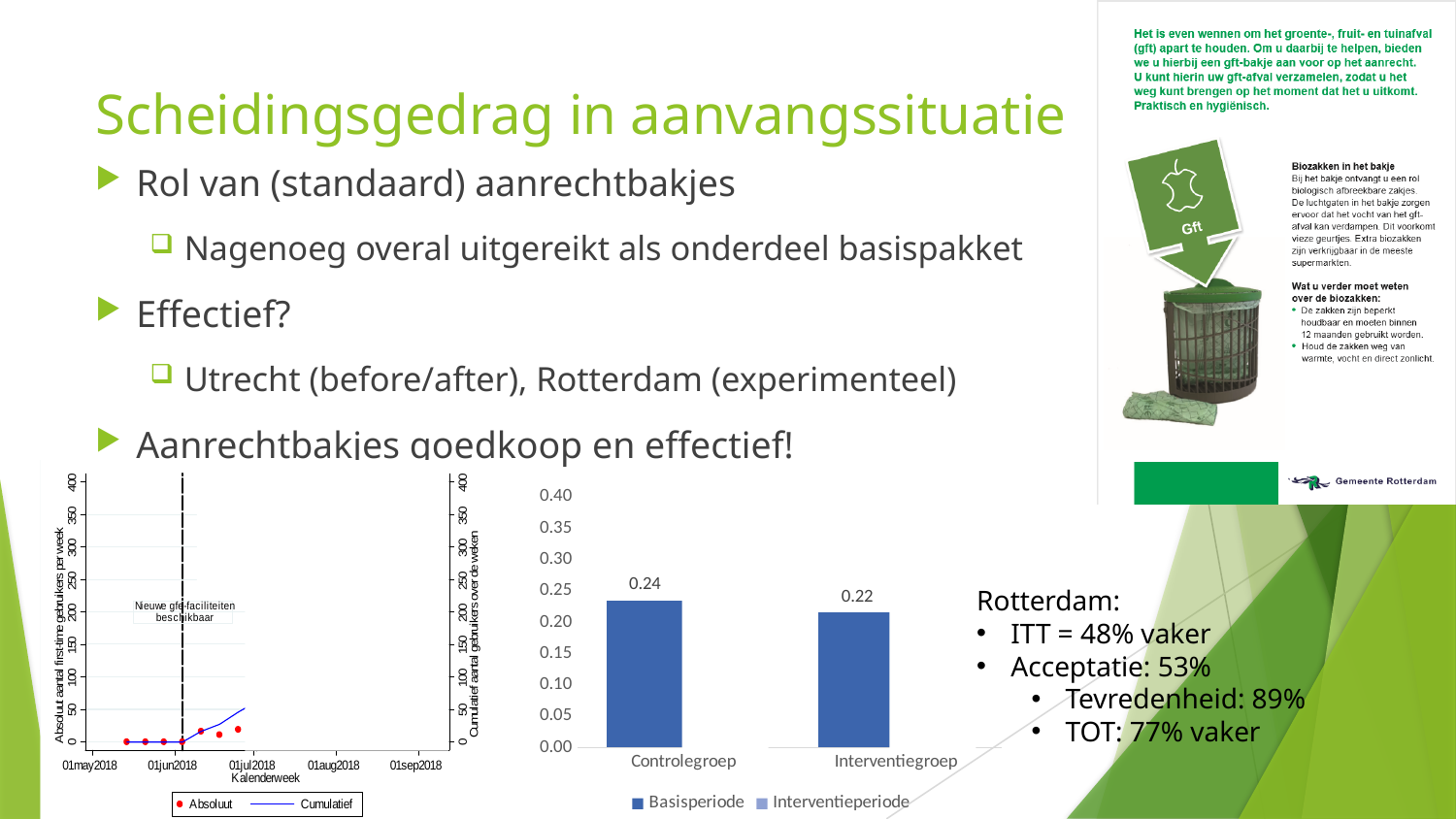
In the bar chart in the middle of the slide, what is the difference between the Controlegroep and Interventiegroep values? 0.02 How many categories are shown on the x axis of the bar chart in the middle of the slide? 2 In the bar chart in the middle of the slide, what is the value for Interventiegroep? 0.22 What kind of chart is the chart in the middle of the slide? bar chart In the bar chart in the middle of the slide, is the value for Controlegroep greater or less than 0.20? greater In the bar chart in the middle of the slide, which group has the lower value? Interventiegroep What is the x-axis label of the chart at the bottom left of the slide? Kalenderweek How many series does the legend of the bar chart in the middle of the slide list? 2 In the chart at the bottom left of the slide, how many series does the legend list? 2 In the bar chart in the middle of the slide, which group has the higher value? Controlegroep In the chart at the bottom left of the slide, does the Cumulatief line rise or fall after 01jun2018? rise In the bar chart in the middle of the slide, what is the value for Controlegroep? 0.24